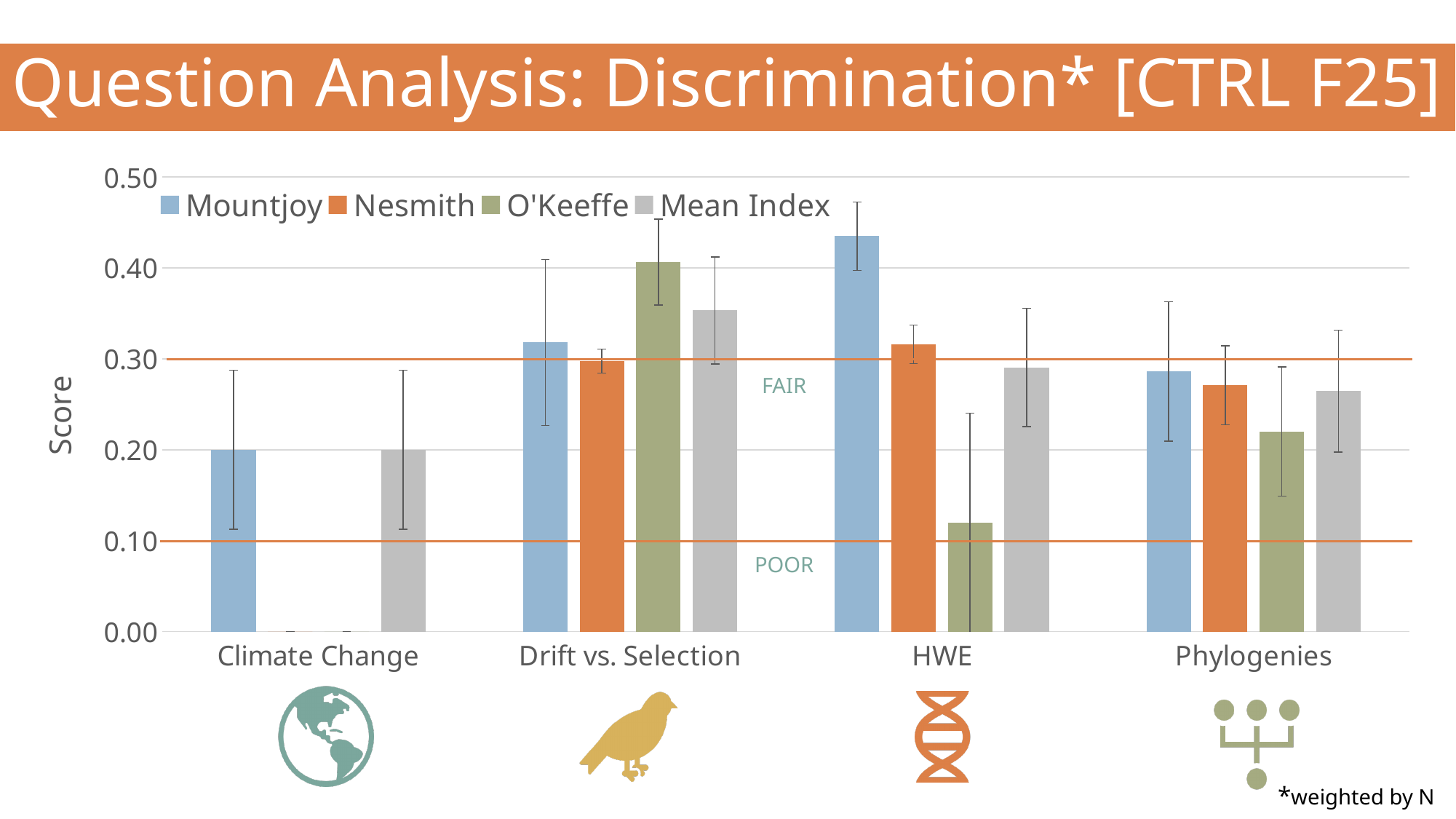
For which category is the O'Keeffe bar lowest? Climate Change How many series does the legend list? 4 Which is larger for Drift vs. Selection, the O'Keeffe value or the Nesmith value? O'Keeffe Is the Mean Index value for Drift vs. Selection greater or less than 0.30? greater What is the label on the y axis of the chart? Score What kind of chart is shown on the slide? bar chart Is the Mountjoy value for HWE greater or less than 0.40? greater How many categories are shown on the x axis? 4 Is the O'Keeffe value for Phylogenies greater or less than 0.30? less For which category is the Mean Index bar highest? Drift vs. Selection Which is larger for HWE, the Mountjoy value or the O'Keeffe value? Mountjoy For which category is the Mountjoy bar highest? HWE